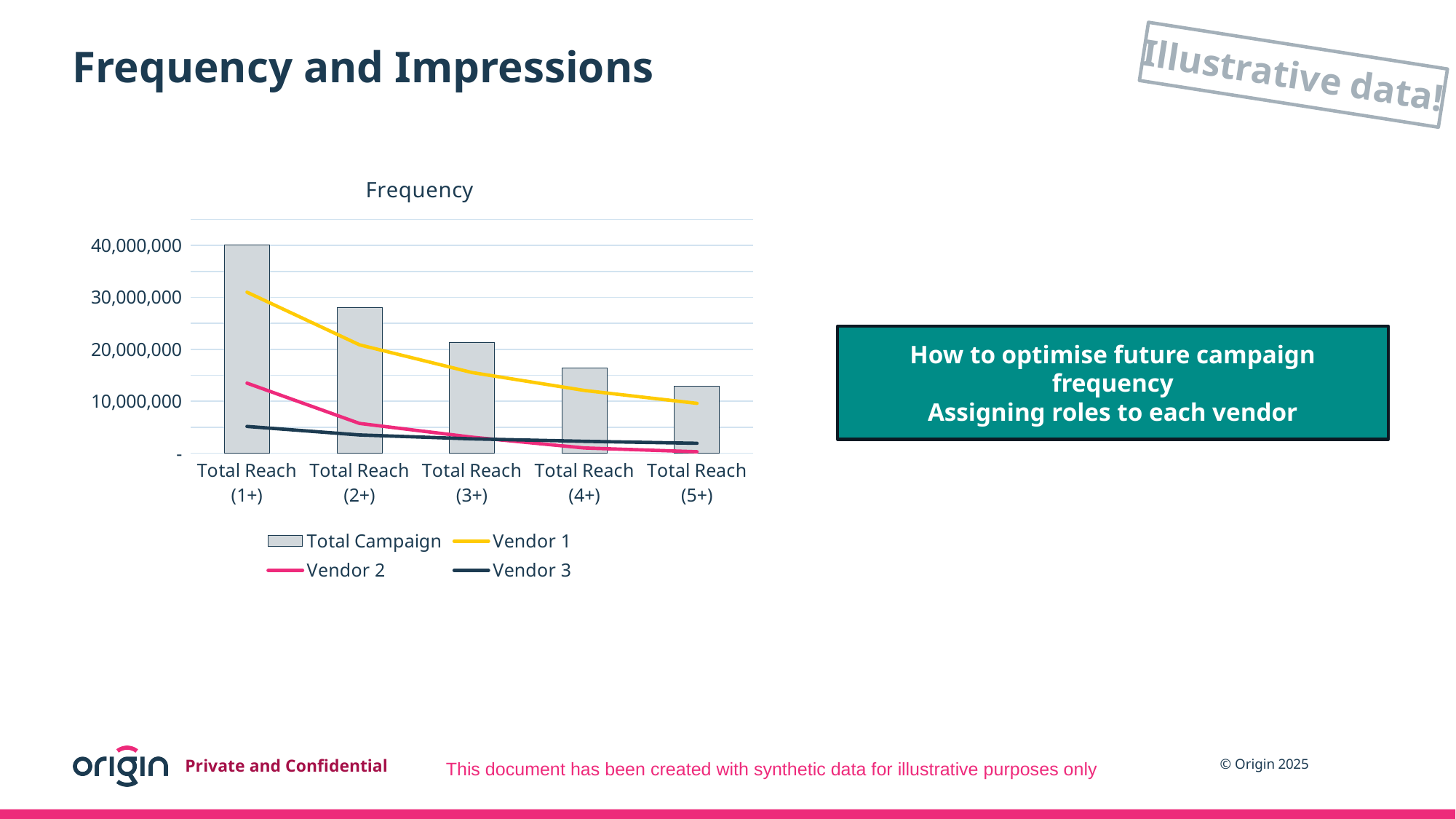
Is the Vendor 1 value for Total Reach (3+) greater or less than 20,000,000? less Which category has the lowest Total Campaign bar? Total Reach (5+) Is the Total Campaign value for Total Reach (5+) greater or less than 10,000,000? greater How many series does the legend of the Frequency chart list? 4 Which category has the highest Total Campaign bar? Total Reach (1+) Is the Total Campaign value for Total Reach (2+) greater or less than 20,000,000? greater What is the title of the chart? Frequency What kind of chart is the Frequency chart? A combined bar and line chart At Total Reach (1+), which is larger: Vendor 1 or Vendor 2? Vendor 1 Do the Total Campaign values rise or fall from Total Reach (1+) to Total Reach (5+)? Fall How many categories are shown on the x axis of the Frequency chart? 5